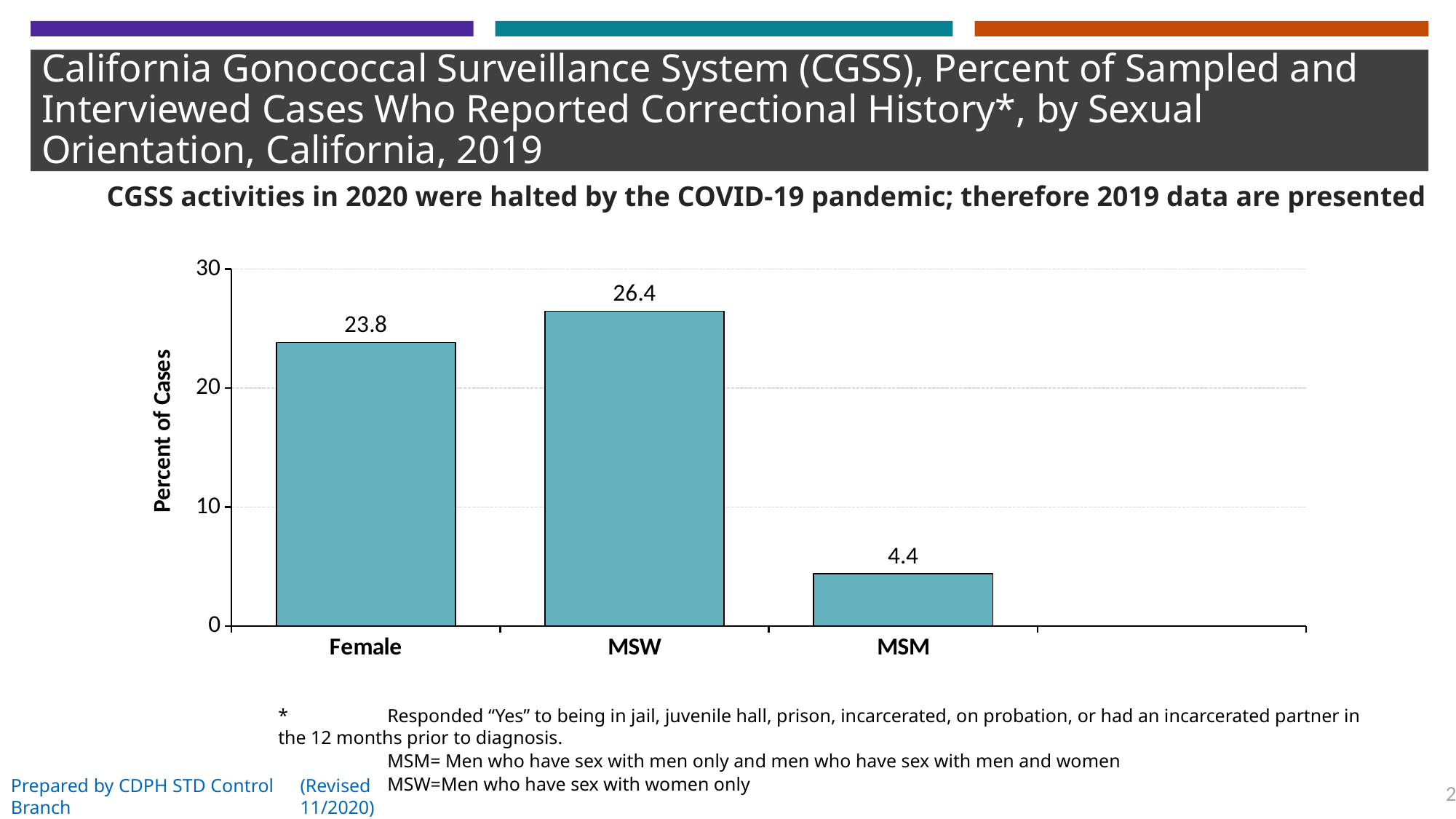
Which category has the lowest percent of cases? MSM What is the percent of cases for MSM? 4.4 What is the difference between the percent of cases for Female and MSM? 19.4 Is the value for MSM greater or less than 10? less What is the label of the y axis? Percent of Cases What is the difference between the percent of cases for MSW and Female? 2.6 What kind of chart is shown on the slide? bar chart What is the percent of cases for MSW? 26.4 Which category has the highest percent of cases? MSW Which is larger, the value for Female or the value for MSM? Female How many categories are shown on the x axis? 3 What is the percent of cases for Female? 23.8